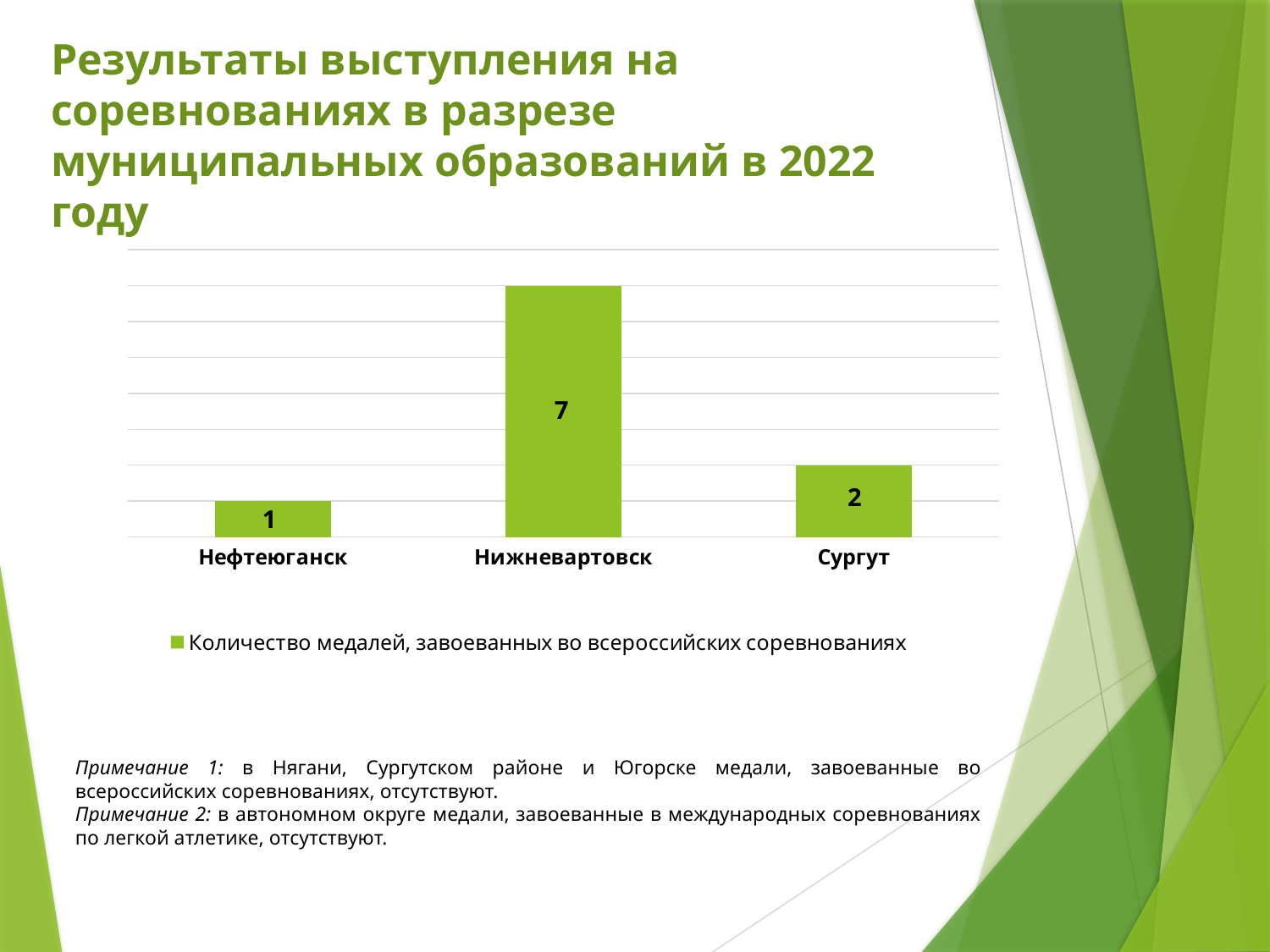
What is the number of medals won in all-Russian competitions for Сургут? 2 Which has more medals, Сургут or Нефтеюганск? Сургут What is the number of medals won in all-Russian competitions for Нижневартовск? 7 What is the difference in medals between Сургут and Нефтеюганск? 1 Which municipality has the highest number of medals? Нижневартовск What is the number of medals won in all-Russian competitions for Нефтеюганск? 1 What series name is shown in the chart legend? Количество медалей, завоеванных во всероссийских соревнованиях What is the difference in medals between Нижневартовск and Сургут? 5 How many municipalities are shown on the chart? 3 How many series does the legend list? 1 Which municipality has the lowest number of medals? Нефтеюганск What kind of chart is shown on the slide? Bar chart